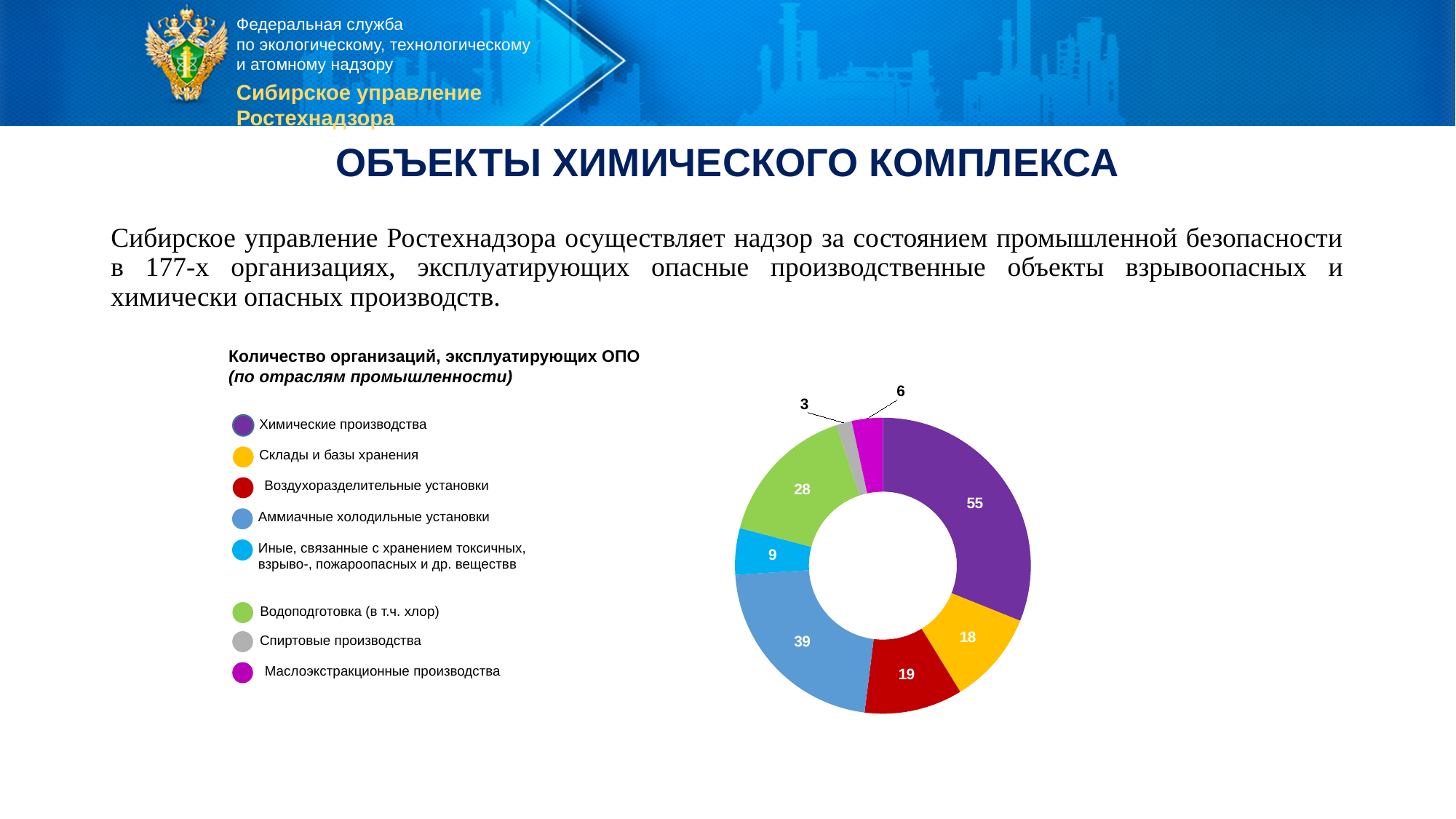
Which category has the largest slice in the chart? Химические производства Which is larger: the value for Воздухоразделительные установки or for Склады и базы хранения? Воздухоразделительные установки What is the value for ammonia refrigeration units (Аммиачные холодильные установки)? 39 What is the total of all slice values in the chart? 177 How many organisations operate chemical production facilities (Химические производства)? 55 What is the value for alcohol production (Спиртовые производства)? 3 What is the difference between the values for Химические производства and Аммиачные холодильные установки? 16 What colour is the slice for Маслоэкстракционные производства? Magenta What kind of chart is shown on the slide? Doughnut (pie) chart Which category has the smallest slice in the chart? Спиртовые производства How many categories (slices) does the chart contain? 8 What is the value for water treatment (Водоподготовка (в т.ч. хлор))? 28